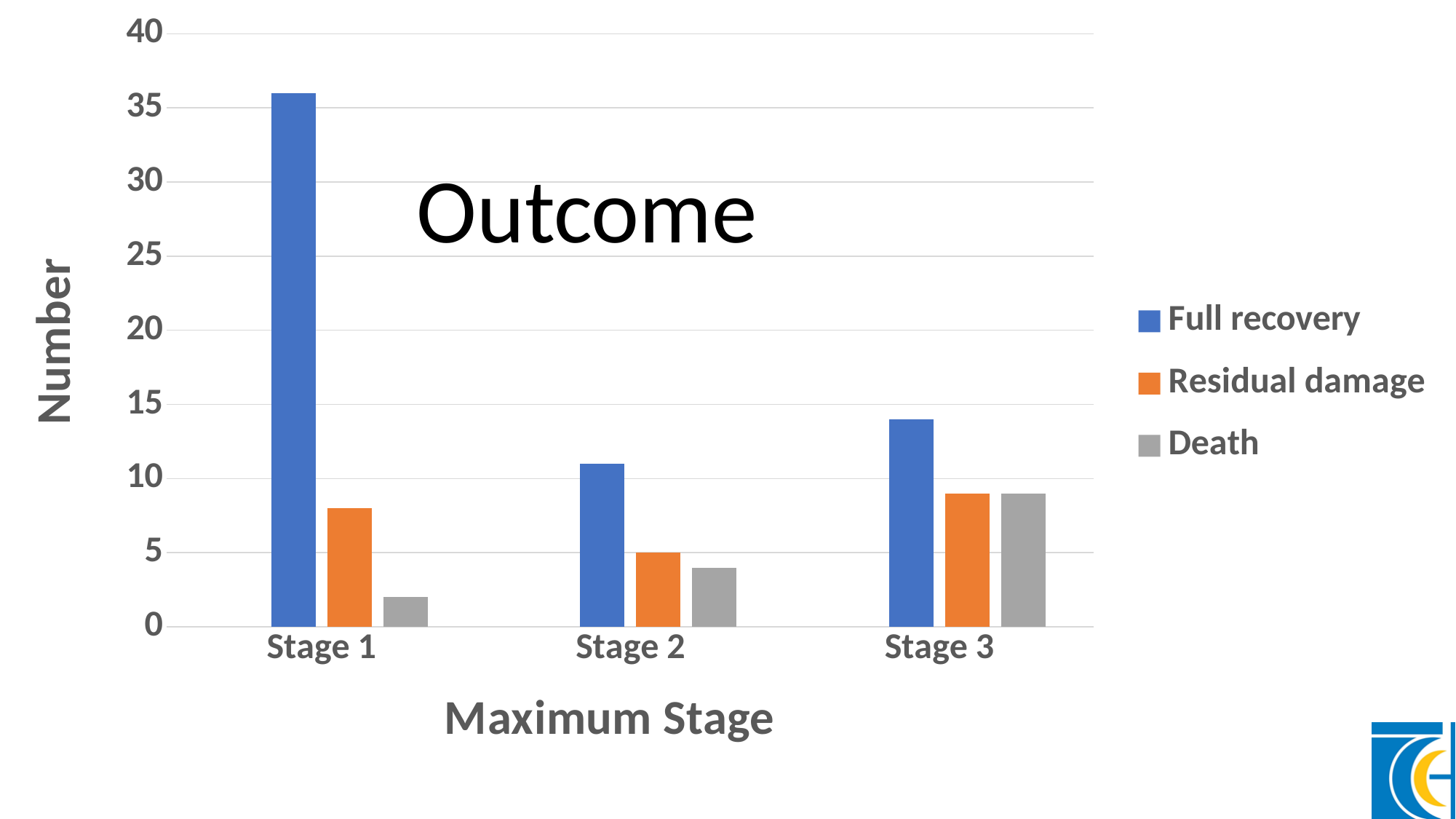
How many stage categories are shown on the x axis? 3 Which stage has the lowest Full recovery value? Stage 2 How many series does the legend list? 3 What kind of chart is shown on the slide? bar chart Do the Death values rise or fall from Stage 1 to Stage 3? rise Is the Full recovery value for Stage 1 greater or less than 35? greater Which stage has the highest Full recovery value? Stage 1 What is the label of the x axis? Maximum Stage Is the Death value for Stage 1 greater or less than 5? less Is the Full recovery value for Stage 3 greater or less than 15? less Which is larger, the Residual damage value for Stage 1 or for Stage 2? Stage 1 What is the title of the chart? Outcome